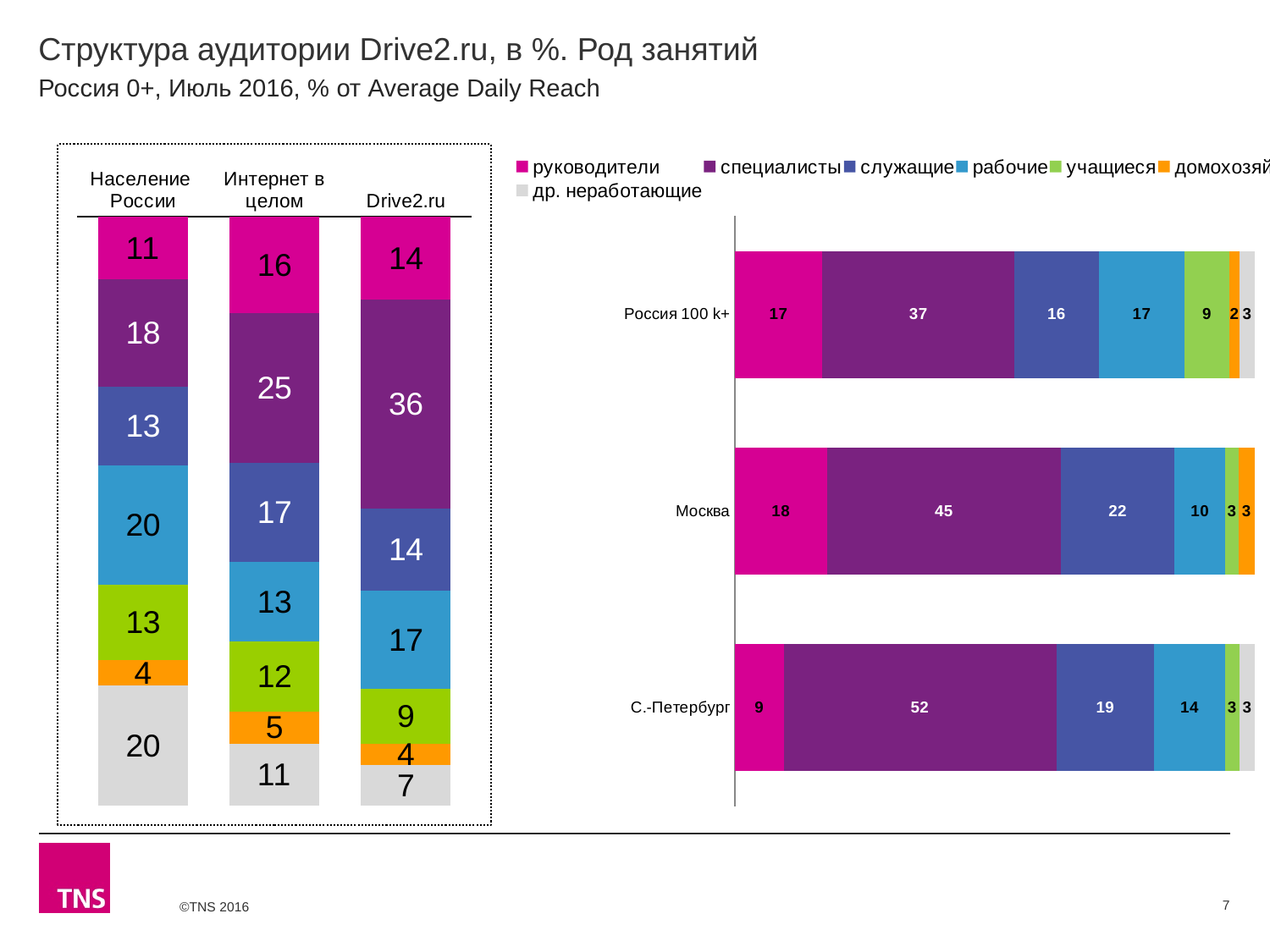
In the right chart, which is larger: the служащие value for Москва or for Россия 100 k+? Москва In the left chart, what is the value for руководители in the Интернет в целом column? 16 How many series does the legend of the right chart list? 7 In the left chart, what is the value for специалисты in the Drive2.ru column? 36 In the left chart, what is the difference between the специалисты value for Drive2.ru and for Население России? 18 What kind of chart is the right chart? Stacked bar chart In the left chart, which column has the lowest value for специалисты? Население России In the left chart, what is the value for рабочие in the Население России column? 20 In the right chart, which category has the highest value for специалисты? С.-Петербург In the right chart, what is the value for специалисты for Москва? 45 How many categories (bars) does the right chart show? 3 In the right chart, what is the value for руководители for С.-Петербург? 9